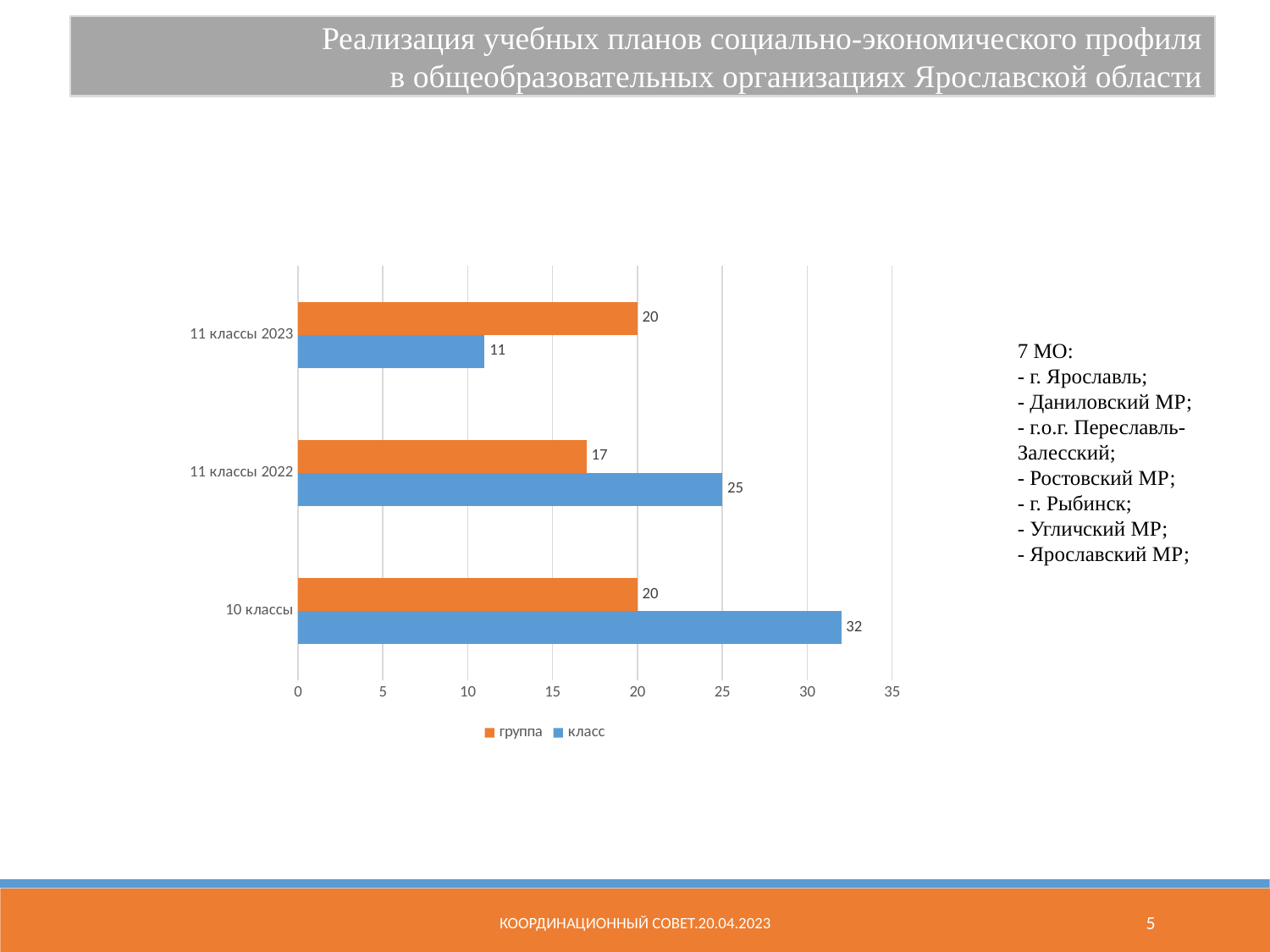
Which colour represents the "группа" series in the chart? orange How many categories are shown on the chart? 3 Which category has the highest value for the "класс" series? 10 классы What kind of chart is shown on the slide? bar chart Which category has the lowest value for the "класс" series? 11 классы 2023 What is the value for "группа" in the "11 классы 2022" category? 17 What is the value for "класс" in the "11 классы 2023" category? 11 How many series does the legend list? 2 What is the value for "группа" in the "11 классы 2023" category? 20 Which is larger in the "11 классы 2023" category: "группа" or "класс"? группа What is the difference between the "класс" and "группа" values in the "10 классы" category? 12 What is the value for "класс" in the "10 классы" category? 32